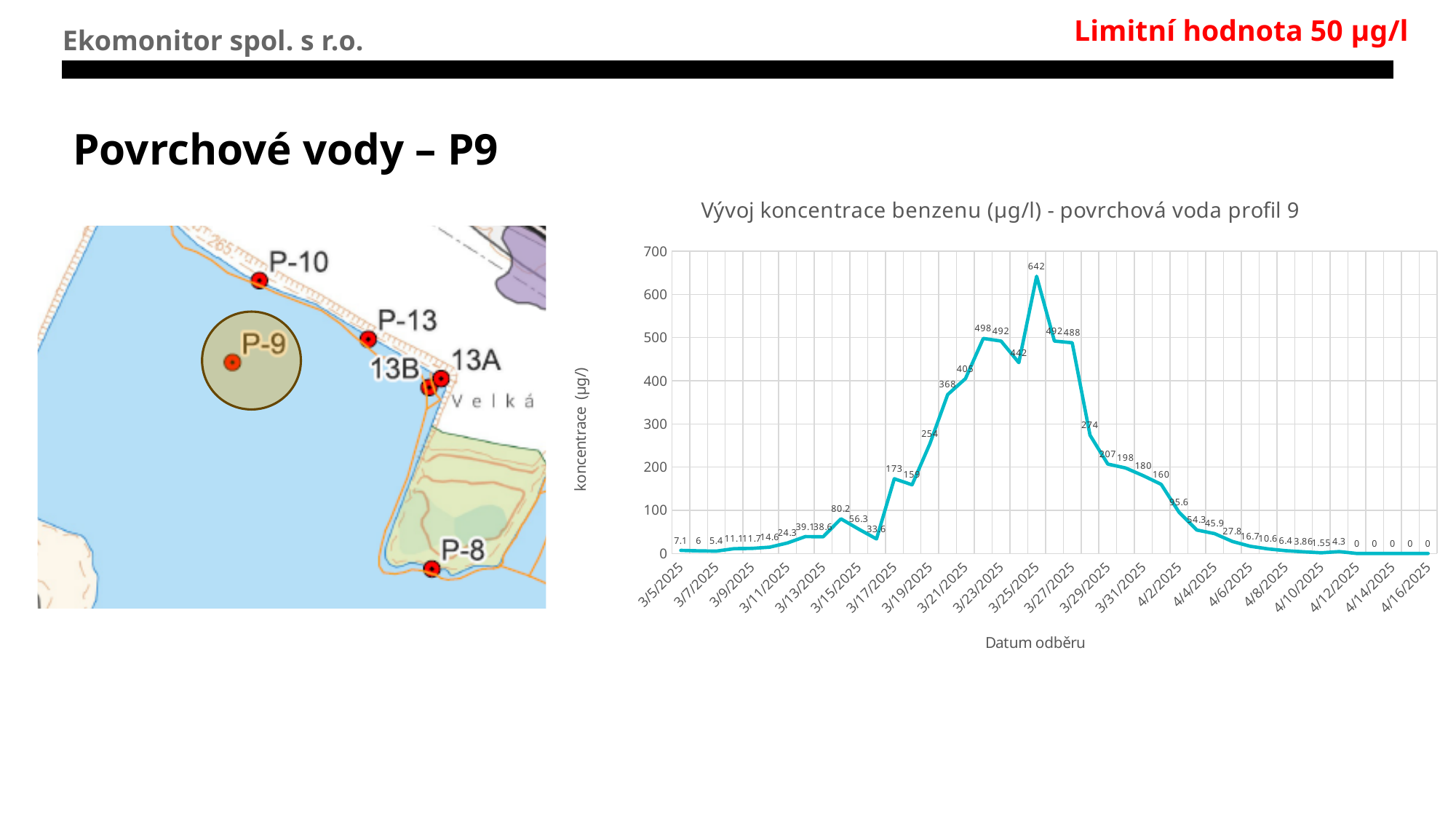
Which date has the larger value, 3/5/2025 or 4/16/2025? 3/5/2025 What kind of chart is shown on the slide? line chart What is the value plotted for 4/16/2025? 0 What is the title of the chart? Vývoj koncentrace benzenu (µg/l) - povrchová voda profil 9 What is the label of the vertical axis of the chart? koncentrace (µg/l) What is the difference between the peak value of 642 and the first value of 7.1? 634.9 What is the value plotted for 3/5/2025? 7.1 Do the values rise or fall along the x axis from 3/25/2025 to 4/16/2025? fall What is the highest value labelled on the line? 642 Is the value for 3/25/2025 greater or less than 600? greater What is the value plotted at the peak on 3/25/2025? 642 What is the lowest value labelled on the line? 0